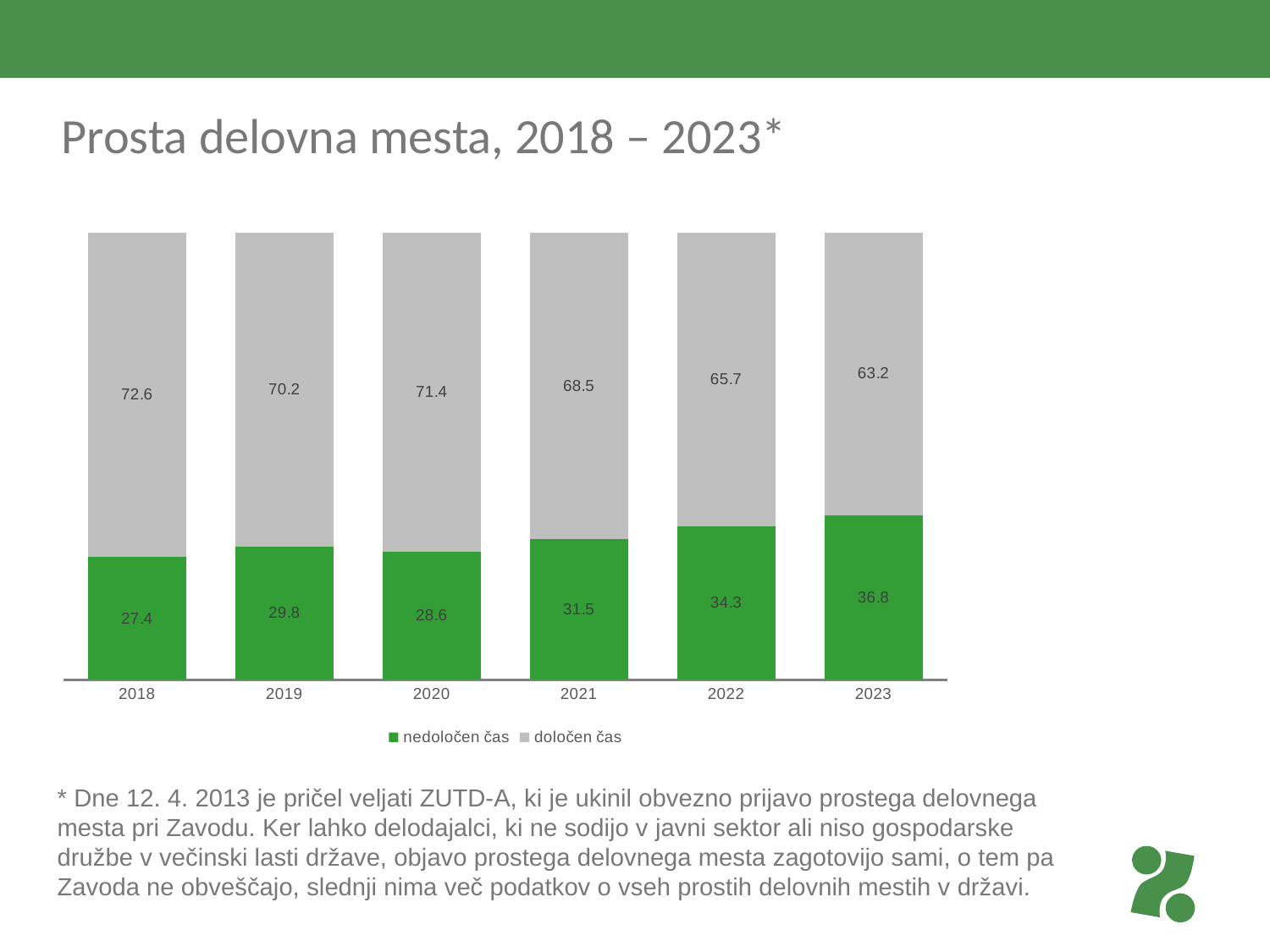
How many years are shown on the x axis? 6 Which year has the lowest value for "določen čas"? 2023 What is the value for "nedoločen čas" in 2021? 31.5 Which colour represents "nedoločen čas" in the chart? Green Which year has the highest value for "nedoločen čas"? 2023 What is the value for "nedoločen čas" in 2018? 27.4 What is the difference between the "določen čas" value in 2018 and in 2023? 9.4 How many series does the legend list? 2 What kind of chart is shown on the slide? Stacked bar chart Does the "nedoločen čas" value rise or fall from 2020 to 2023? Rise What is the value for "določen čas" in 2023? 63.2 Which is larger: the "nedoločen čas" value in 2019 or in 2020? 2019